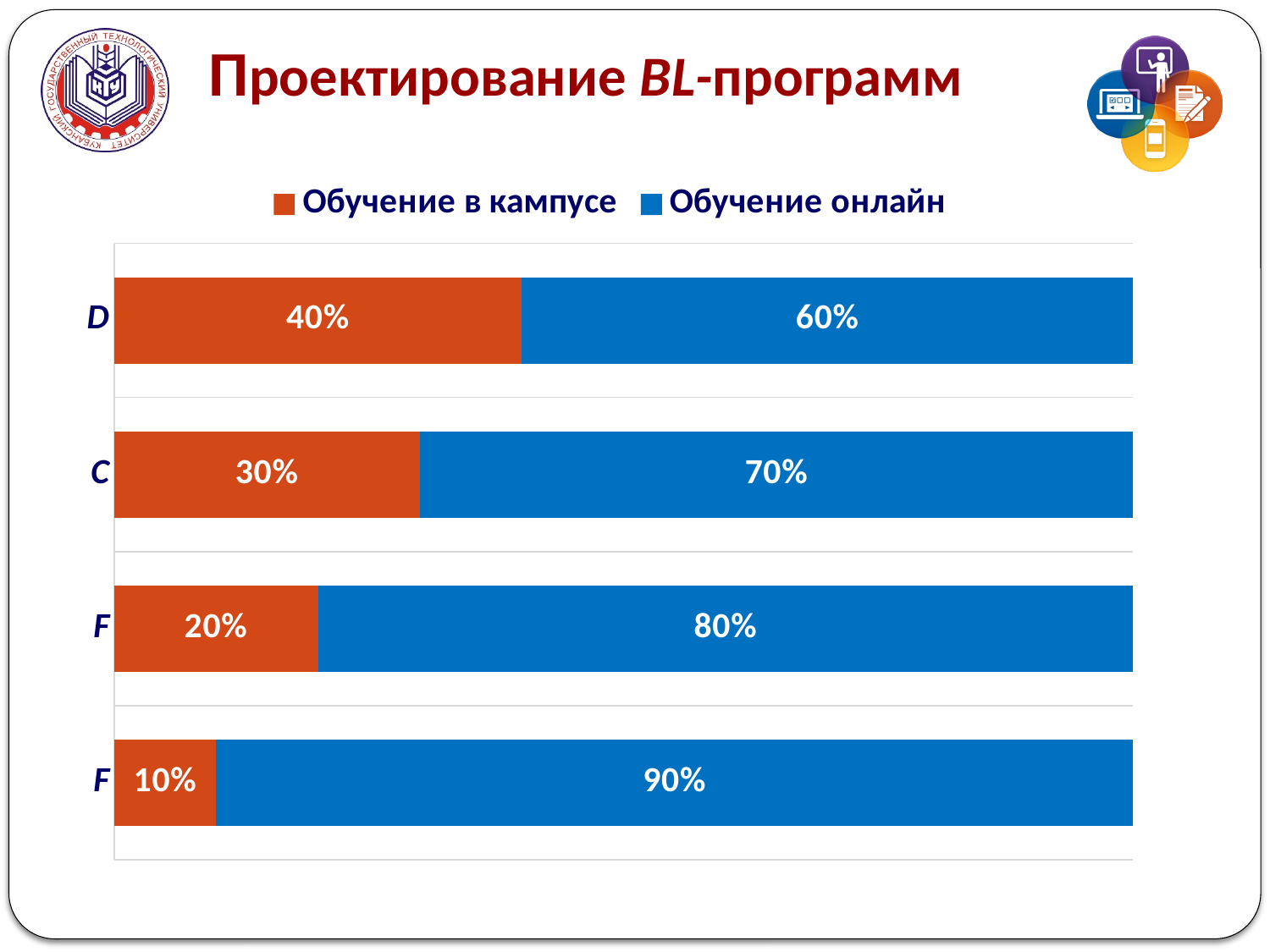
What is the difference between the "Обучение онлайн" values for category C and category D? 10% How many bars (categories) are plotted in the chart? 4 Which category has the lowest value for "Обучение онлайн"? D How many series does the legend list? 2 What is the value of "Обучение в кампусе" for category D? 40% What is the total of the stacked bar for category C? 100% What is the value of "Обучение в кампусе" for the third bar from the top (labeled F)? 20% What is the value of "Обучение онлайн" for the bottom bar labeled F? 90% What is the value of "Обучение онлайн" for category C? 70% Which category has the highest value for "Обучение в кампусе"? D What kind of chart is shown on the slide? Stacked bar chart Which is larger: the "Обучение в кампусе" value for category C or for category D? D